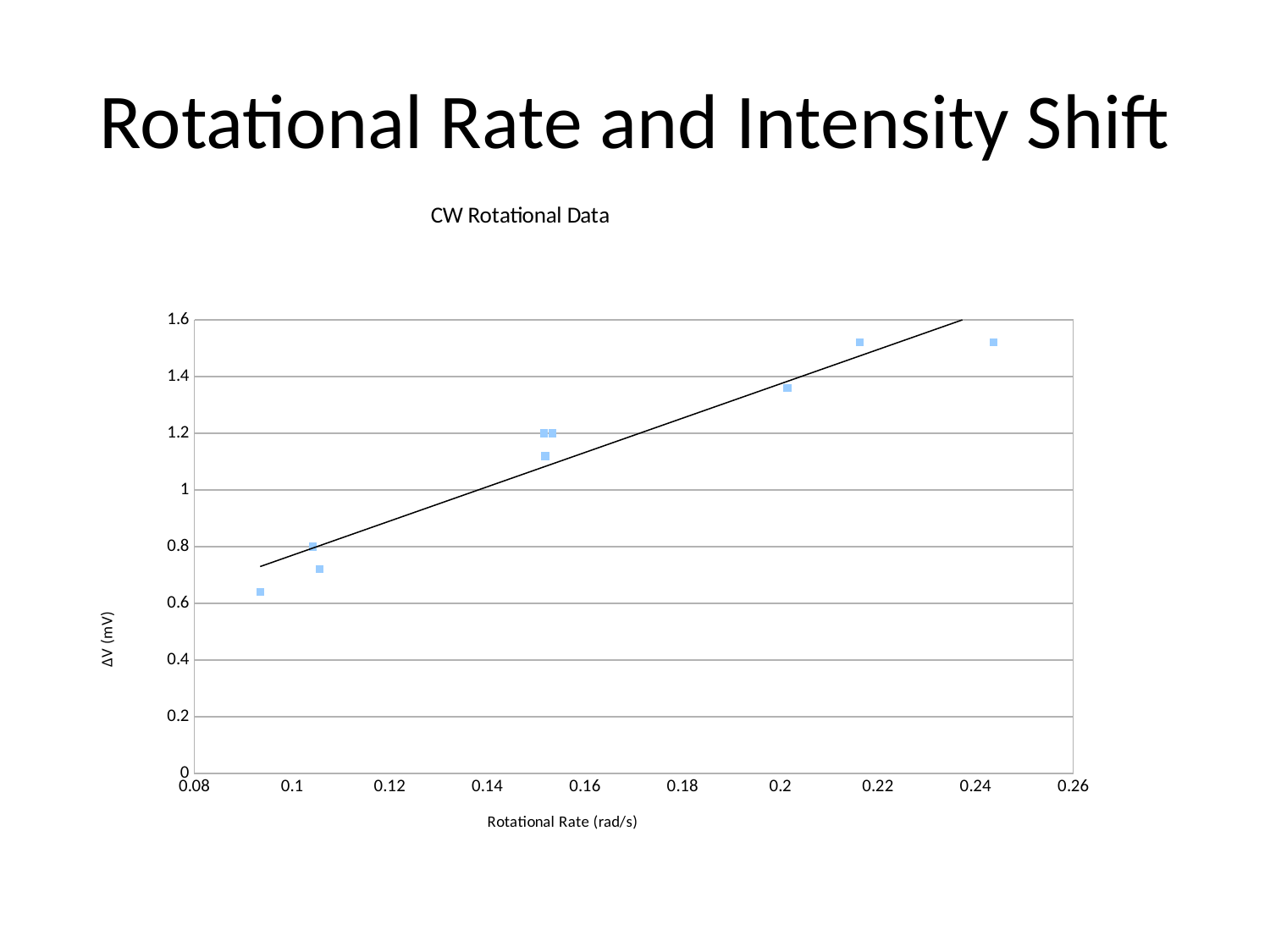
Is the ΔV value of the leftmost data point greater or less than 0.8 mV? less What is the label of the x axis? Rotational Rate (rad/s) How many data points are plotted on the chart? 9 Is the ΔV value of the leftmost data point greater or less than 0.6 mV? greater Is the ΔV value of the rightmost data point greater or less than 1.4 mV? greater What is the highest value shown on the y axis? 1.6 What is the title of the chart? CW Rotational Data Which has the larger ΔV: the data point near 0.2 rad/s or the data point near 0.1 rad/s? The point near 0.2 rad/s Does the data point with the lowest ΔV occur at the smallest or the largest rotational rate? smallest Do the ΔV values rise or fall as the rotational rate increases? Rise What kind of chart is shown on the slide? Scatter chart